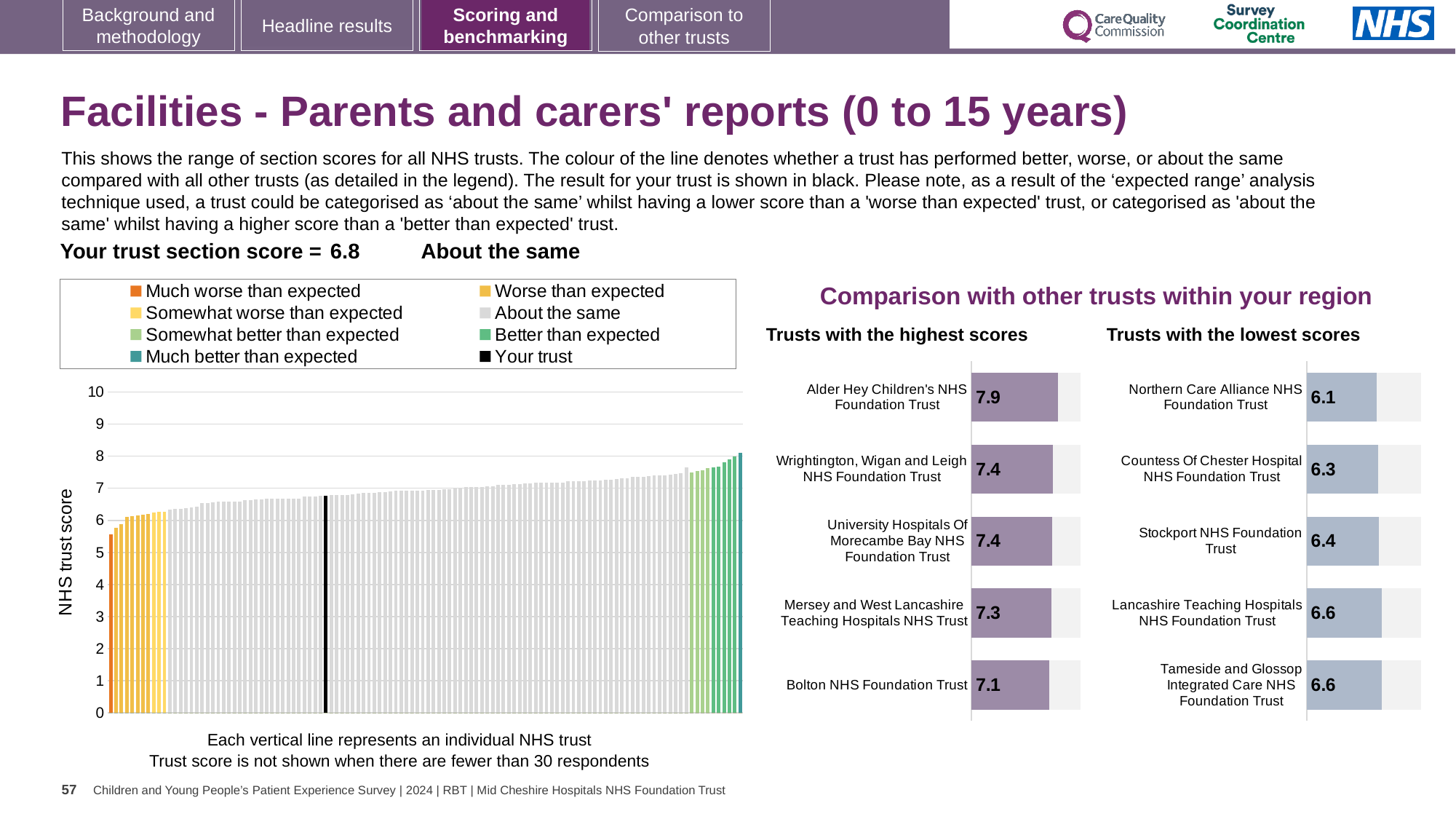
In the 'Trusts with the lowest scores' chart, what is the score for Northern Care Alliance NHS Foundation Trust? 6.1 What kind of chart is the large chart on the left showing NHS trust scores? Bar chart In the 'Trusts with the lowest scores' chart, which has the larger score: Countess Of Chester Hospital NHS Foundation Trust or Stockport NHS Foundation Trust? Stockport NHS Foundation Trust How many entries does the legend above the large chart on the left list? 8 In the 'Trusts with the highest scores' chart, what is the score for Bolton NHS Foundation Trust? 7.1 In the large chart on the left, do the NHS trust scores rise or fall from left to right? Rise In the 'Trusts with the highest scores' chart, what is the difference between the scores of Alder Hey Children's NHS Foundation Trust and Bolton NHS Foundation Trust? 0.8 In the large chart on the left, is the value for the black bar (your trust) greater or less than 5? greater In the 'Trusts with the highest scores' chart, what is the score for Alder Hey Children's NHS Foundation Trust? 7.9 How many trusts are listed in the 'Trusts with the highest scores' chart? 5 In the 'Trusts with the highest scores' chart, which trust has the highest score? Alder Hey Children's NHS Foundation Trust In the 'Trusts with the lowest scores' chart, which trust has the lowest score? Northern Care Alliance NHS Foundation Trust